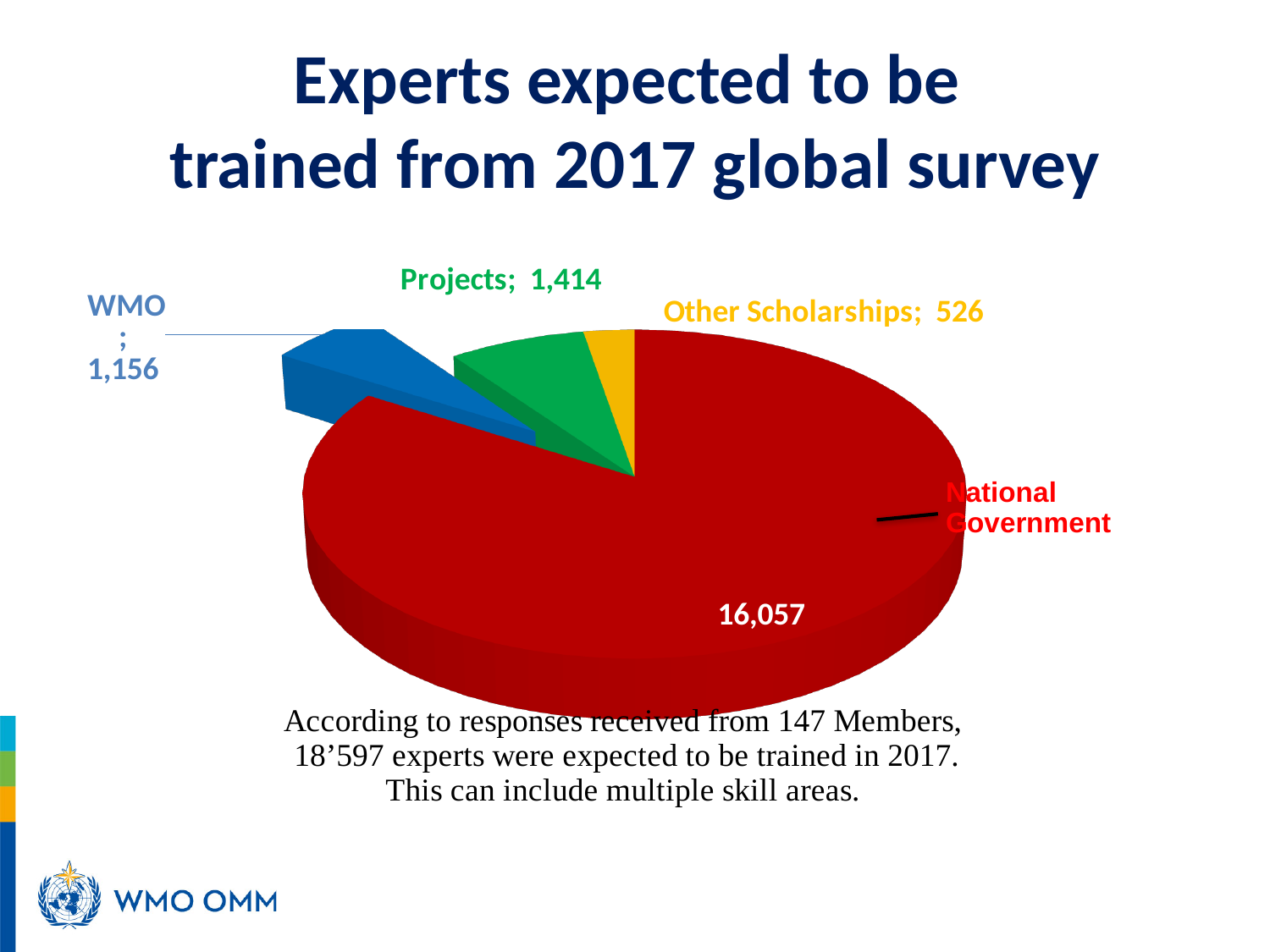
What kind of chart is shown on the slide? Pie chart What is the difference between the National Government value and the Projects value? 14,643 What is the value for Other Scholarships? 526 Which is larger, Projects or WMO? Projects Which category has the smallest slice? Other Scholarships What is the value for Projects? 1,414 What is the difference between the WMO value and the Other Scholarships value? 630 What is the value for National Government? 16,057 What is the title of the slide containing the chart? Experts expected to be trained from 2017 global survey Which category has the largest slice? National Government What is the value for WMO? 1,156 How many slices does the pie chart have? 4